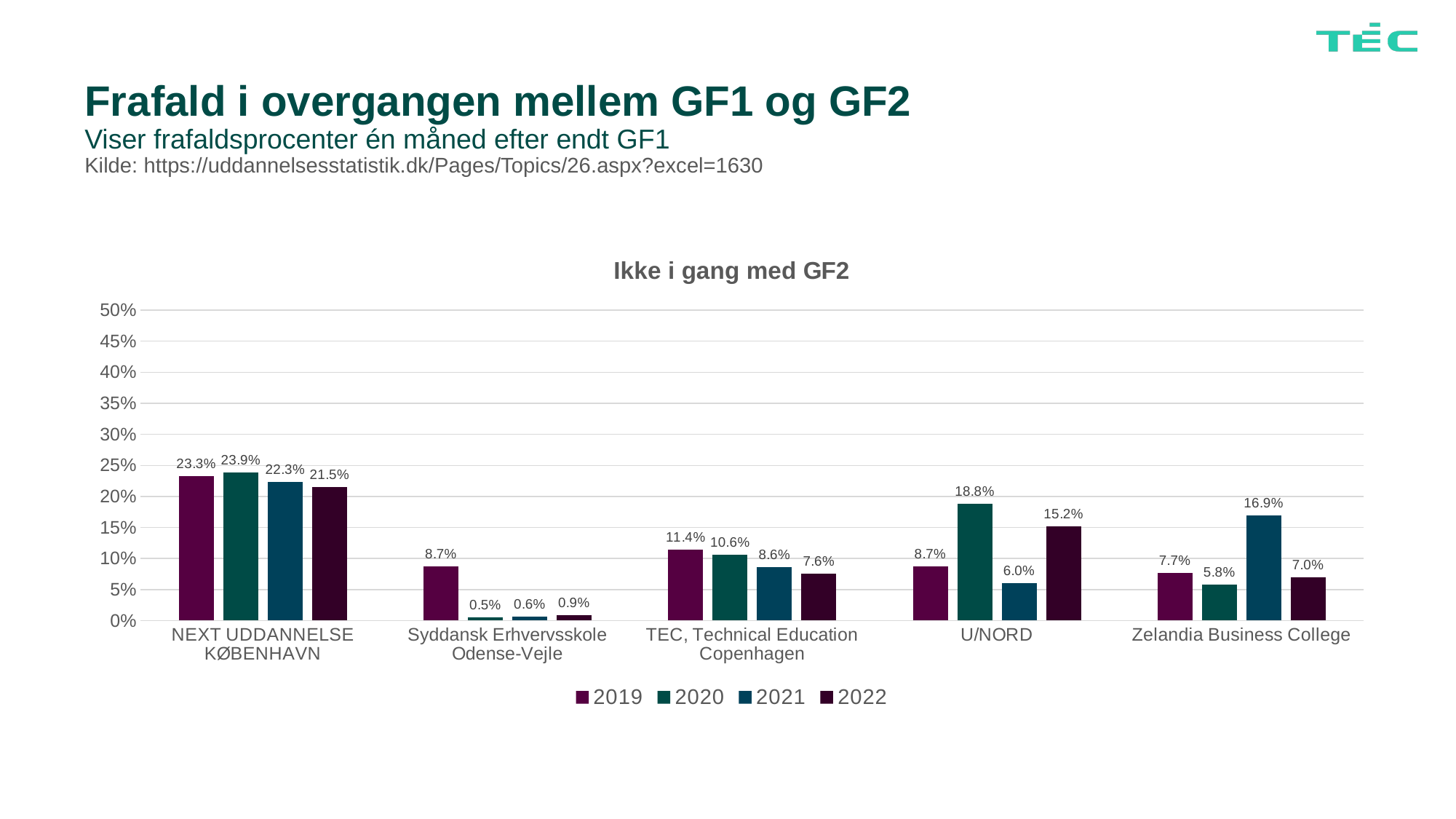
What is the 2019 value for TEC, Technical Education Copenhagen? 11.4% What is the 2021 value for Zelandia Business College? 16.9% How many schools are shown on the x axis? 5 Which school has the lowest 2020 value? Syddansk Erhvervsskole Odense-Vejle What is the 2020 value for NEXT UDDANNELSE KØBENHAVN? 23.9% What is the 2022 value for U/NORD? 15.2% Do the values for TEC, Technical Education Copenhagen rise or fall from 2019 to 2022? fall Which is larger for Zelandia Business College: the 2019 value or the 2022 value? 2019 How many series does the legend list? 4 What is the difference between the 2020 and 2021 values for U/NORD? 12.8% What is the title of the chart? Ikke i gang med GF2 Which school has the highest 2019 value? NEXT UDDANNELSE KØBENHAVN